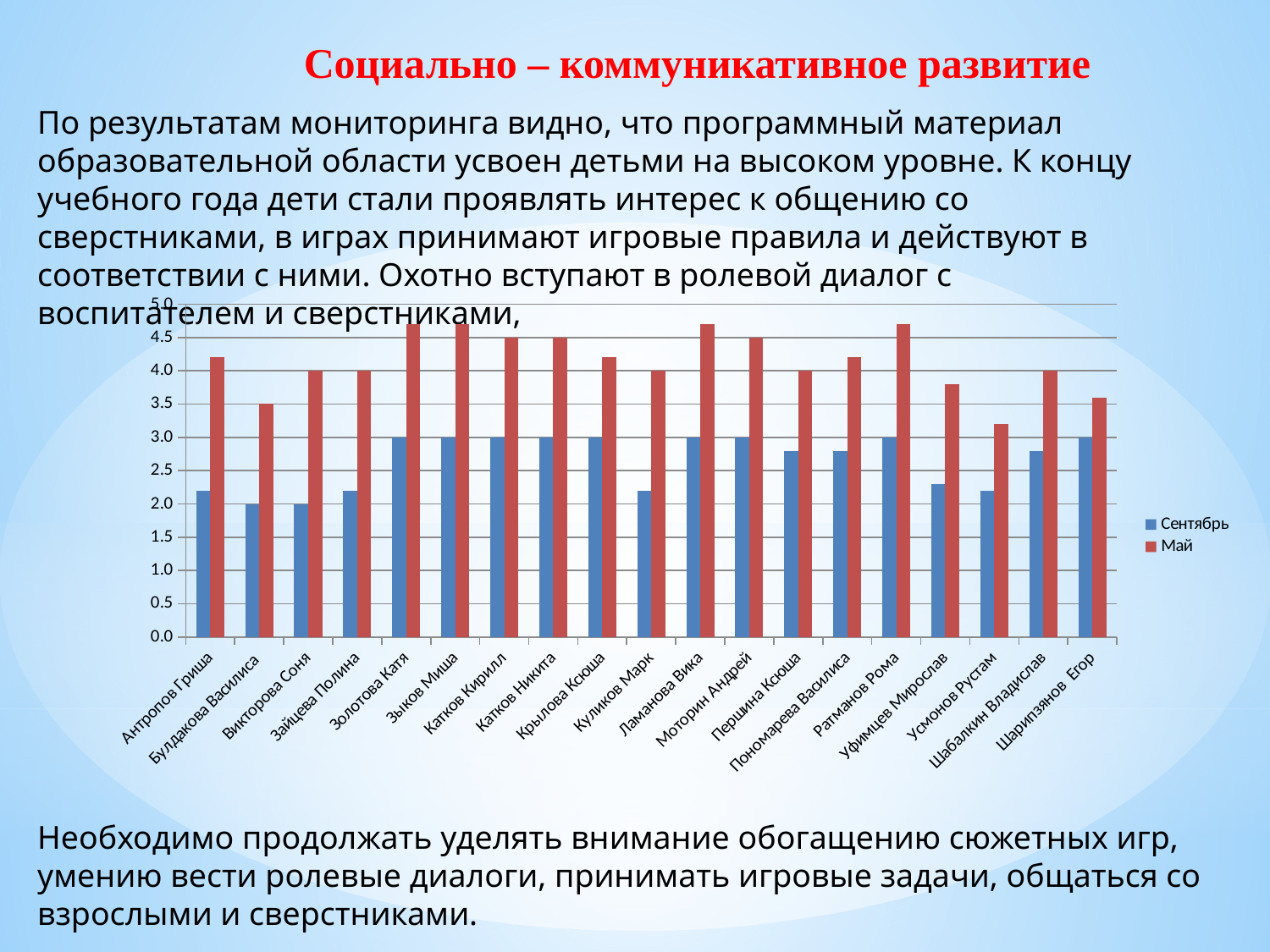
How many series does the legend list? 2 Which is larger for Антропов Гриша: the Сентябрь value or the Май value? Май What is the Май value for Катков Кирилл? 4.5 What is the Сентябрь value for Викторова Соня? 2.0 How many children (categories) are shown on the x axis? 19 What are the two series named in the legend? Сентябрь and Май What kind of chart is shown on the slide? Bar chart What is the Май value for Булдакова Василиса? 3.5 Is the Май value for Золотова Катя greater or less than 4.5? greater Is the Май value for Усмонов Рустам greater or less than 3.5? less Which child has the lowest Май value? Усмонов Рустам What is the difference between the Май and Сентябрь values for Викторова Соня? 2.0